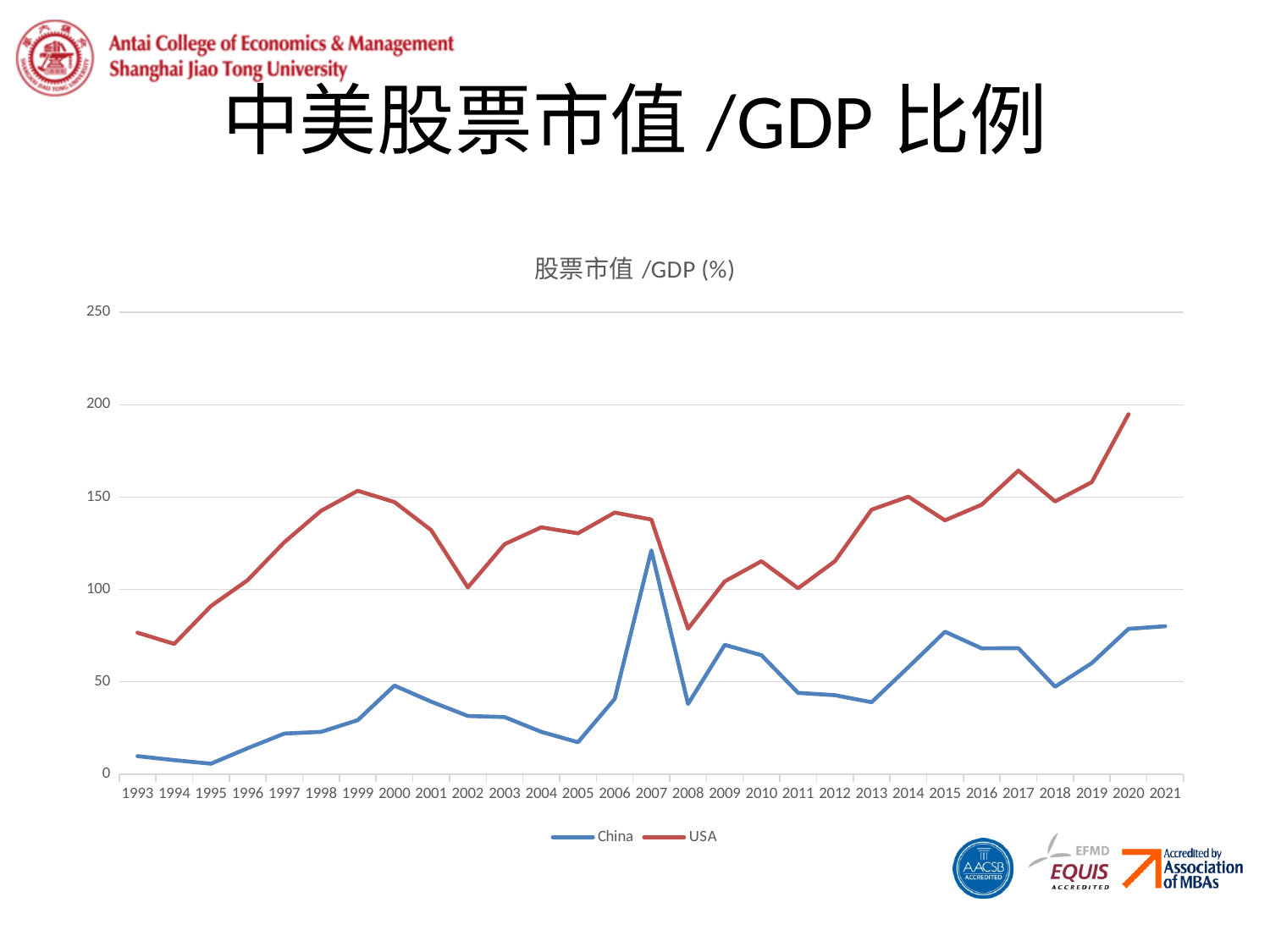
How many years are plotted along the x axis? 29 How many series does the legend list? 2 Is the value for USA in 2020 greater or less than 150? greater In which year does the USA series reach its highest value? 2020 What kind of chart is shown on the slide? line chart Which series is drawn in red according to the legend? USA In which year does the China series reach its highest value? 2007 Is the value for USA in 2008 greater or less than 100? less What is the title printed above the chart? 股票市值 /GDP (%) Is the value for China in 1995 greater or less than 50? less In 2000, which series has the larger value, China or USA? USA